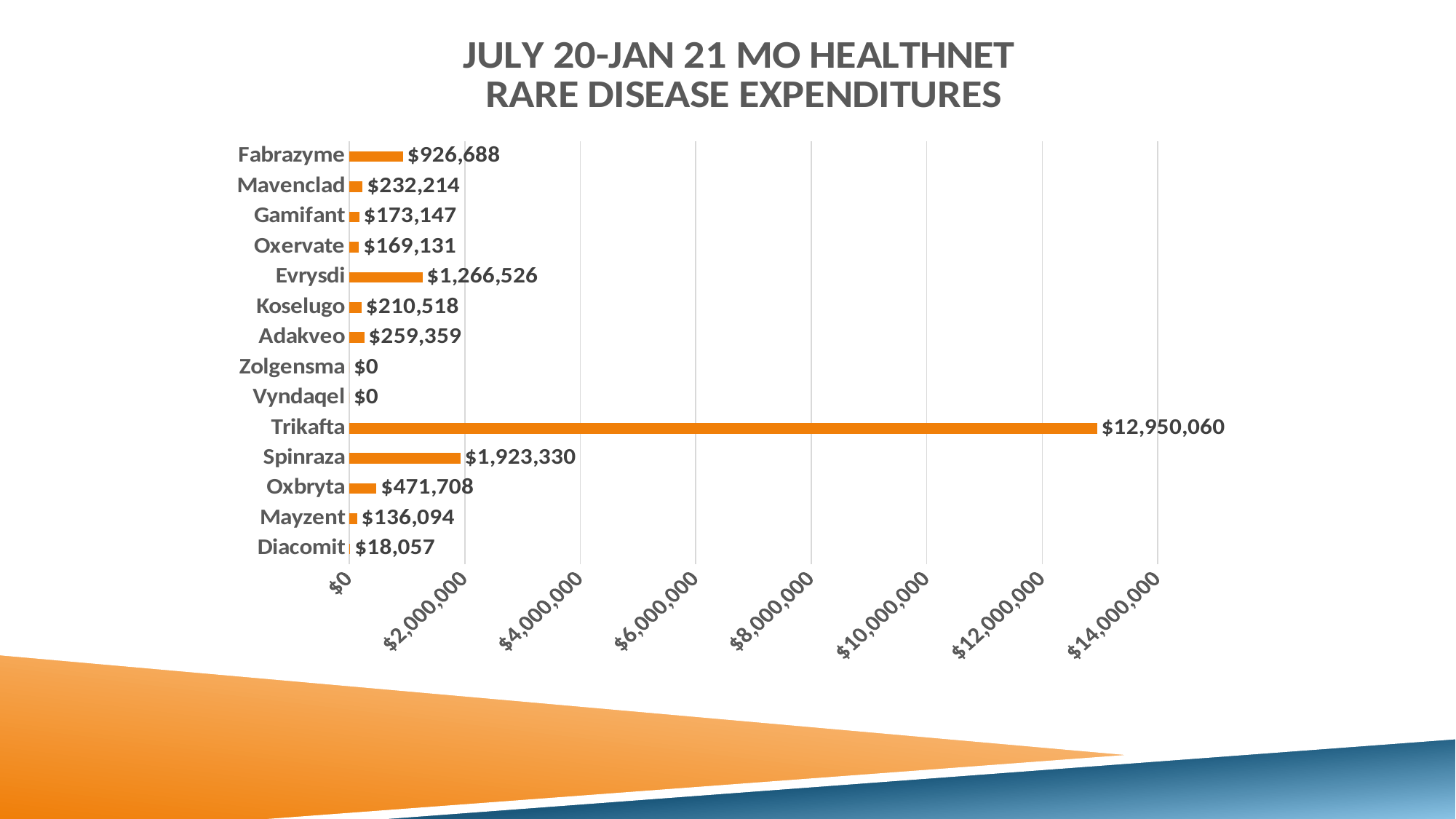
What is the expenditure for Trikafta? $12,950,060 Which drug has the highest expenditure? Trikafta What is the title of the chart? JULY 20-JAN 21 MO HEALTHNET RARE DISEASE EXPENDITURES What type of chart is shown on the slide? bar chart Which two drugs show an expenditure of $0? Zolgensma and Vyndaqel What is the expenditure for Diacomit? $18,057 What is the expenditure for Spinraza? $1,923,330 What is the difference between the expenditures for Fabrazyme and Oxbryta? $454,980 How many drugs are listed on the chart? 14 What is the difference between the expenditures for Spinraza and Evrysdi? $656,804 Is the value for Trikafta greater or less than $12,000,000? greater Which has a larger expenditure, Mavenclad or Adakveo? Adakveo